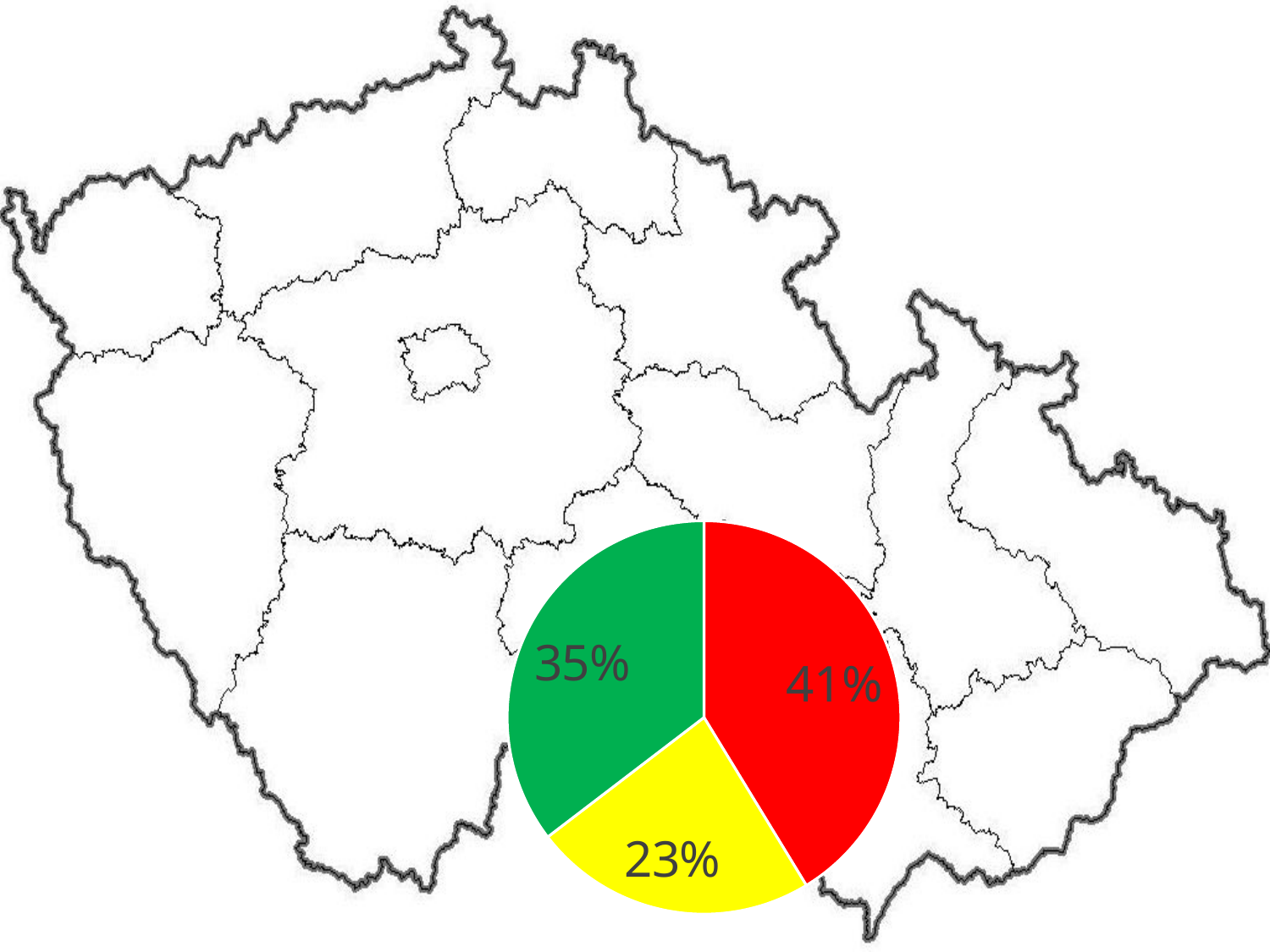
What percentage is shown on the red slice of the pie chart? 41% What is the difference between the green slice and the yellow slice of the pie chart? 12% Which is larger in the pie chart, the green slice or the yellow slice? green What percentage is shown on the yellow slice of the pie chart? 23% How many slices does the pie chart have? 3 Which colour slice of the pie chart is the largest? red Which colour slice of the pie chart is the smallest? yellow What is drawn behind the pie chart on the slide? a map of the Czech Republic with regional borders What kind of chart is shown on the slide? pie chart What is the difference between the red slice and the green slice of the pie chart? 6% What percentage is shown on the green slice of the pie chart? 35% What is the combined share of the red and yellow slices of the pie chart? 64%